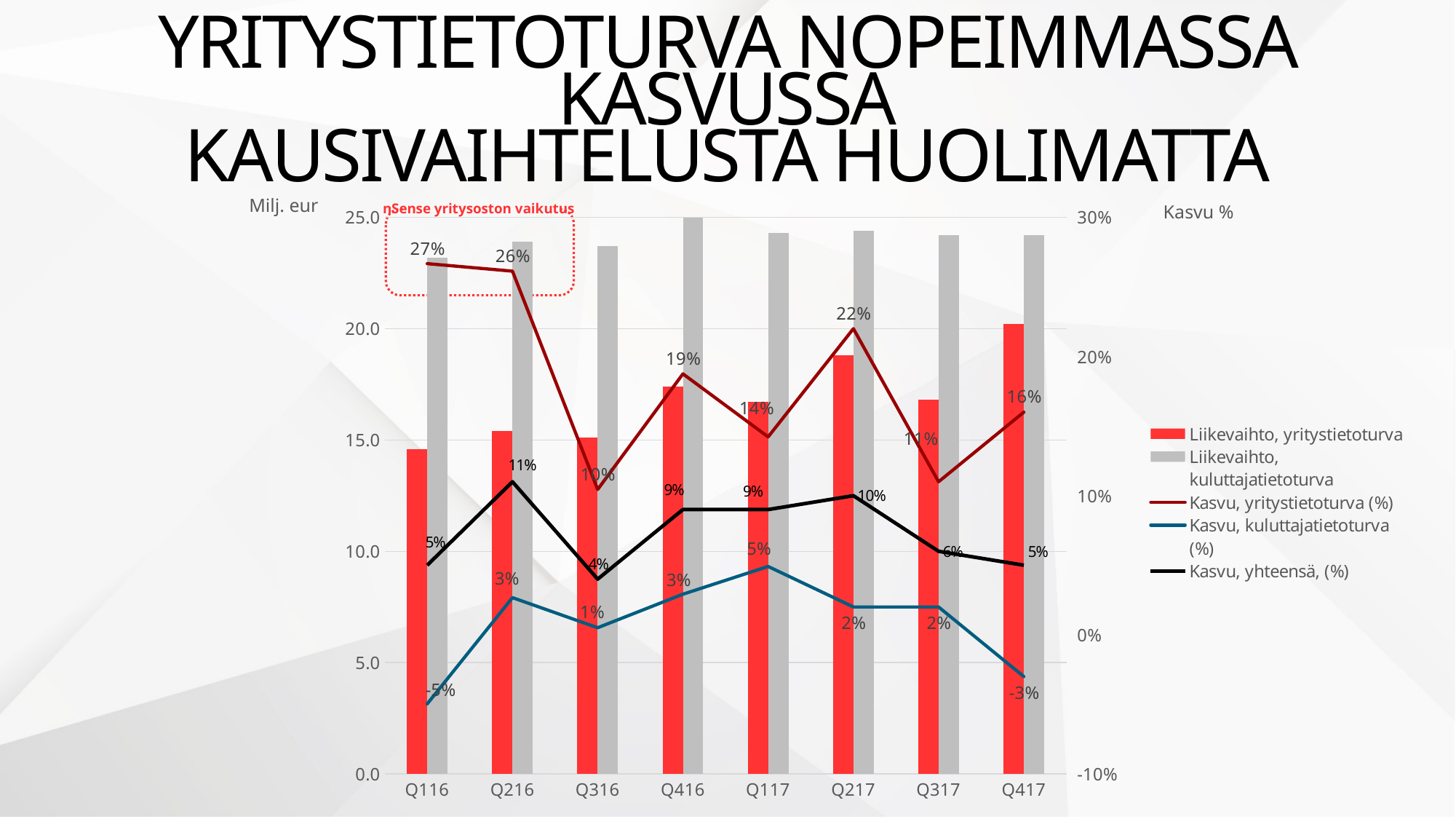
In which quarter is Kasvu, yritystietoturva (%) lowest? Q316 Is the Liikevaihto, kuluttajatietoturva bar for Q116 greater or less than 20.0? greater What is the value of Kasvu, yhteensä, (%) in Q216? 11% How many series does the legend list? 5 What kind of chart is shown on the slide? Combined bar and line chart In which quarter is Kasvu, kuluttajatietoturva (%) highest? Q117 Which is larger: Kasvu, yhteensä, (%) in Q416 or in Q317? Q416 What is the value of Kasvu, kuluttajatietoturva (%) in Q417? -3% What is the value of Kasvu, yritystietoturva (%) in Q116? 27% What is the difference between Kasvu, yritystietoturva (%) in Q217 and Q317? 11 percentage points How many quarters are shown on the x axis? 8